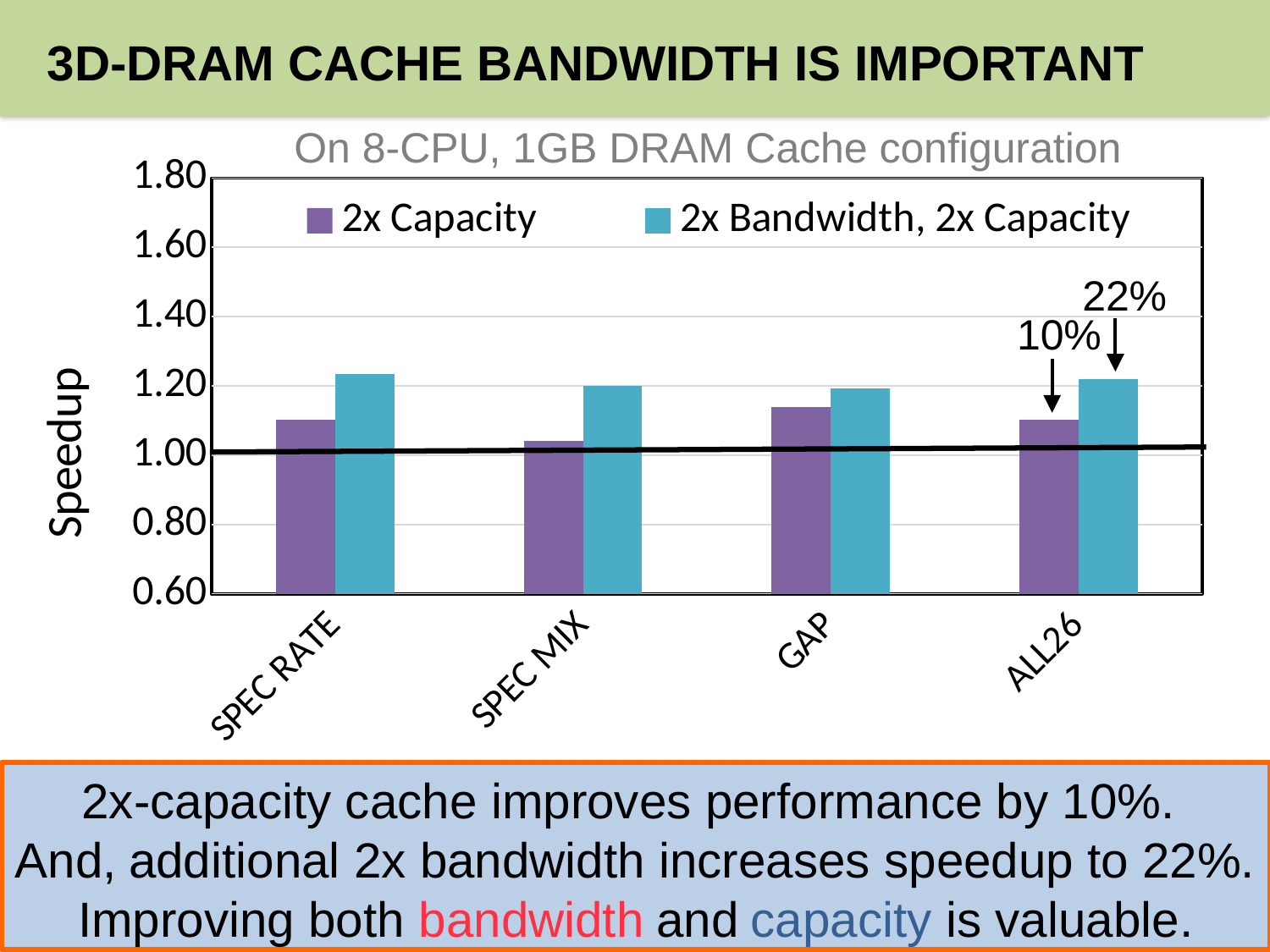
What is the label on the y axis of the chart? Speedup Which category has the lowest 2x Capacity speedup? SPEC MIX What kind of chart is shown on the slide? bar chart For SPEC RATE, which is larger: the 2x Capacity speedup or the 2x Bandwidth, 2x Capacity speedup? 2x Bandwidth, 2x Capacity Is the 2x Bandwidth, 2x Capacity speedup for ALL26 greater or less than 1.40? less Which category has the highest 2x Capacity speedup? GAP What percentage annotation is shown above the 2x Bandwidth, 2x Capacity bar for ALL26? 22% How many series does the chart legend list? 2 Is the 2x Capacity speedup for GAP greater or less than 1.20? less Is the 2x Capacity speedup for SPEC RATE greater or less than 1.00? greater How many categories are shown on the x axis of the chart? 4 For SPEC MIX, which is larger: the 2x Capacity speedup or the 2x Bandwidth, 2x Capacity speedup? 2x Bandwidth, 2x Capacity